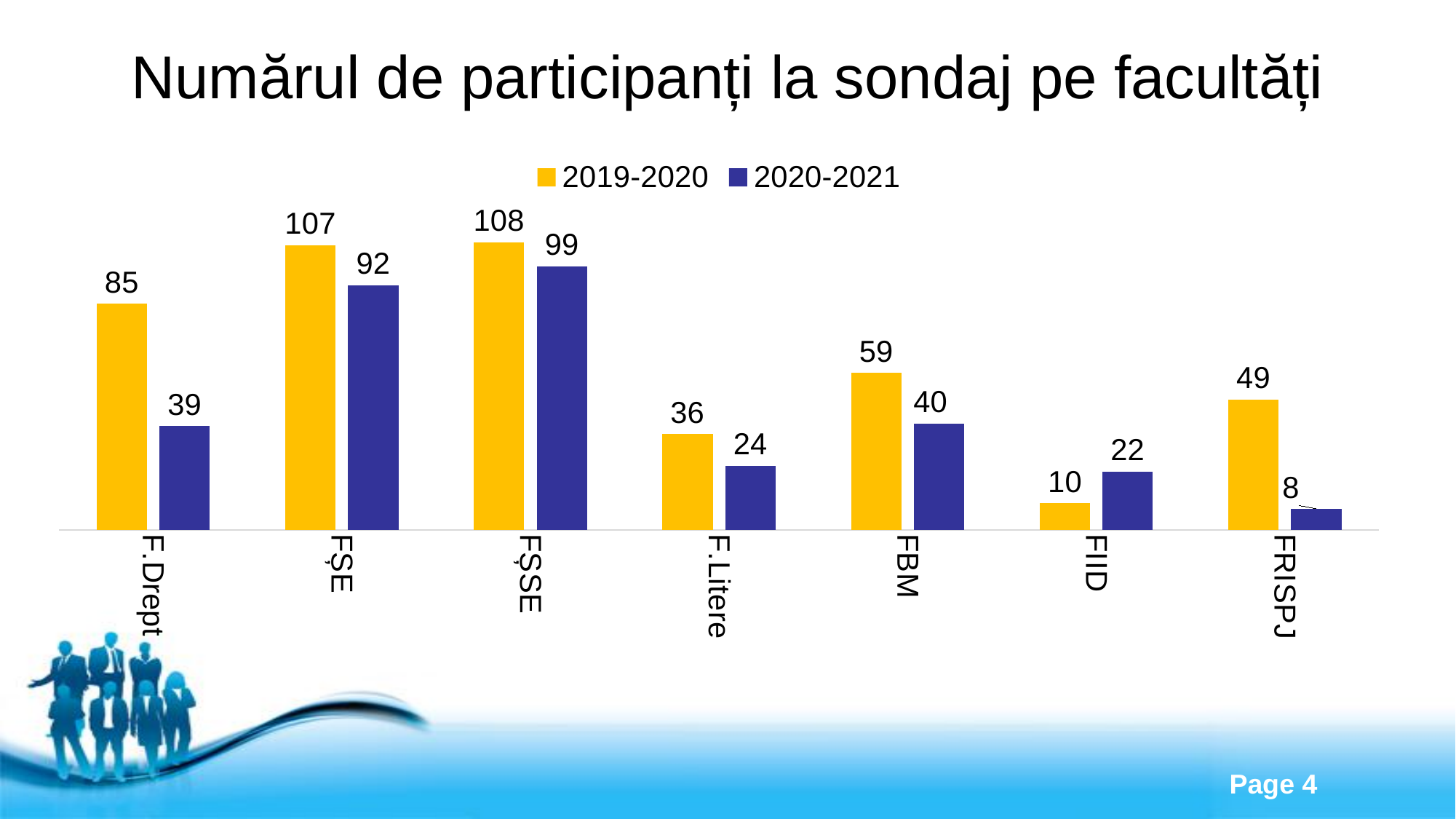
Which faculty has the lowest value in the 2020-2021 series? FRISPJ How many series does the legend list? 2 Which colour represents the 2020-2021 series? Blue What is the value for F.Litere in the 2020-2021 series? 24 What kind of chart is shown on the slide? Bar chart What is the value for FRISPJ in the 2020-2021 series? 8 What is the value for FȘE in the 2019-2020 series? 107 What is the title of the chart? Numărul de participanți la sondaj pe facultăți Which faculty has the highest value in the 2019-2020 series? FȘSE Which is larger for FIID: the 2019-2020 value or the 2020-2021 value? 2020-2021 How many faculties are shown on the x axis? 7 What is the difference between the 2019-2020 and 2020-2021 values for F.Drept? 46